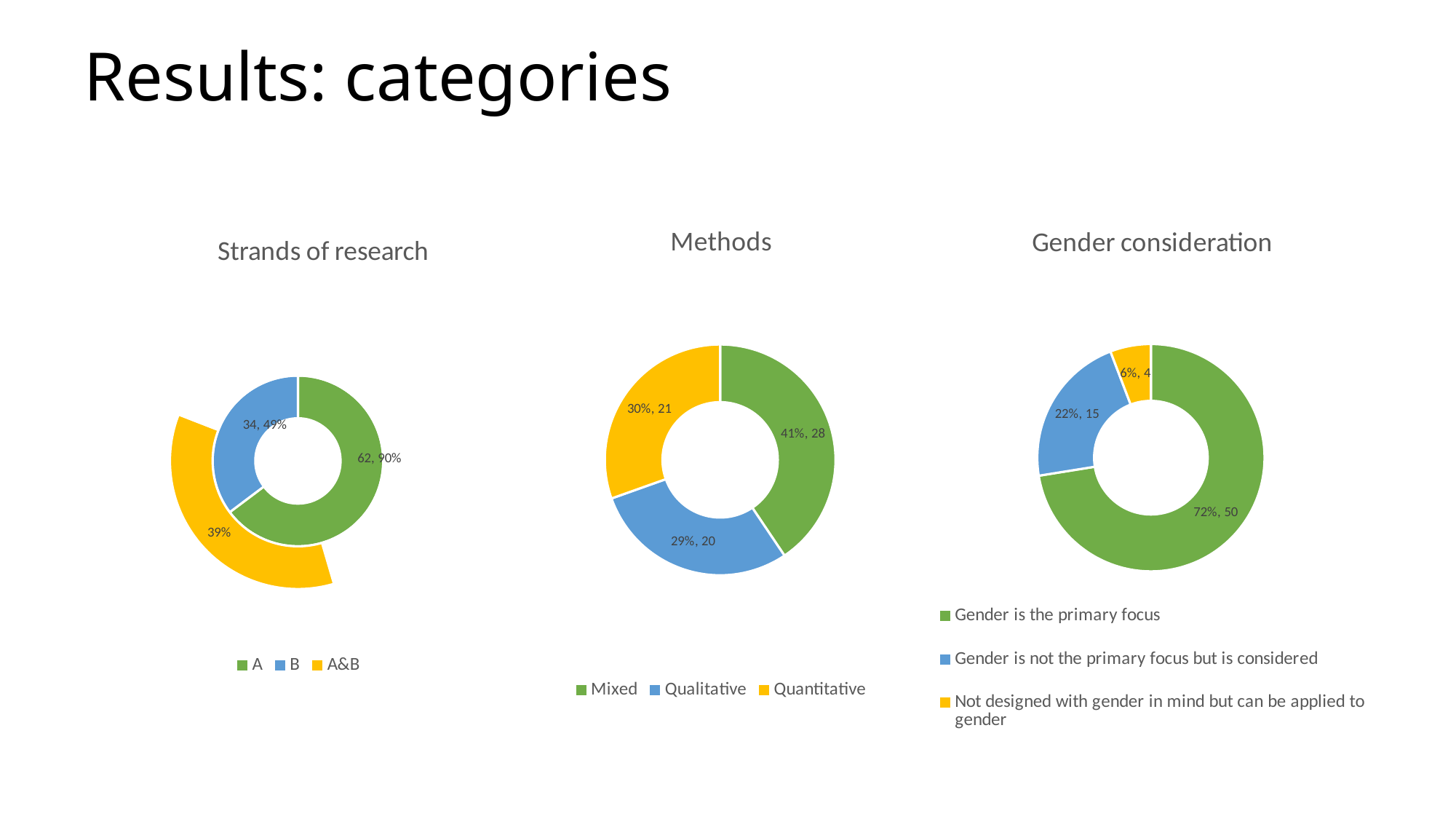
In the Methods chart, which has the larger count, Quantitative or Qualitative? Quantitative In the Gender consideration chart, what percentage share does 'Gender is the primary focus' have? 72% What kind of chart is the Methods chart? Doughnut chart In the Strands of research chart, how many entries does the legend list? 3 In the Methods chart, what is the difference between the Mixed count and the Quantitative count? 7 In the Methods chart, which category has the smallest count? Qualitative In the Methods chart, how many items are labelled Mixed? 28 In the Gender consideration chart, what is the difference between the count for 'Gender is the primary focus' and the count for 'Gender is not the primary focus but is considered'? 35 In the Strands of research chart, what is the data label shown for A? 62, 90% In the Gender consideration chart, what is the count for 'Not designed with gender in mind but can be applied to gender'? 4 In the Methods chart, which category has the largest share? Mixed In the Gender consideration chart, how many categories are shown? 3